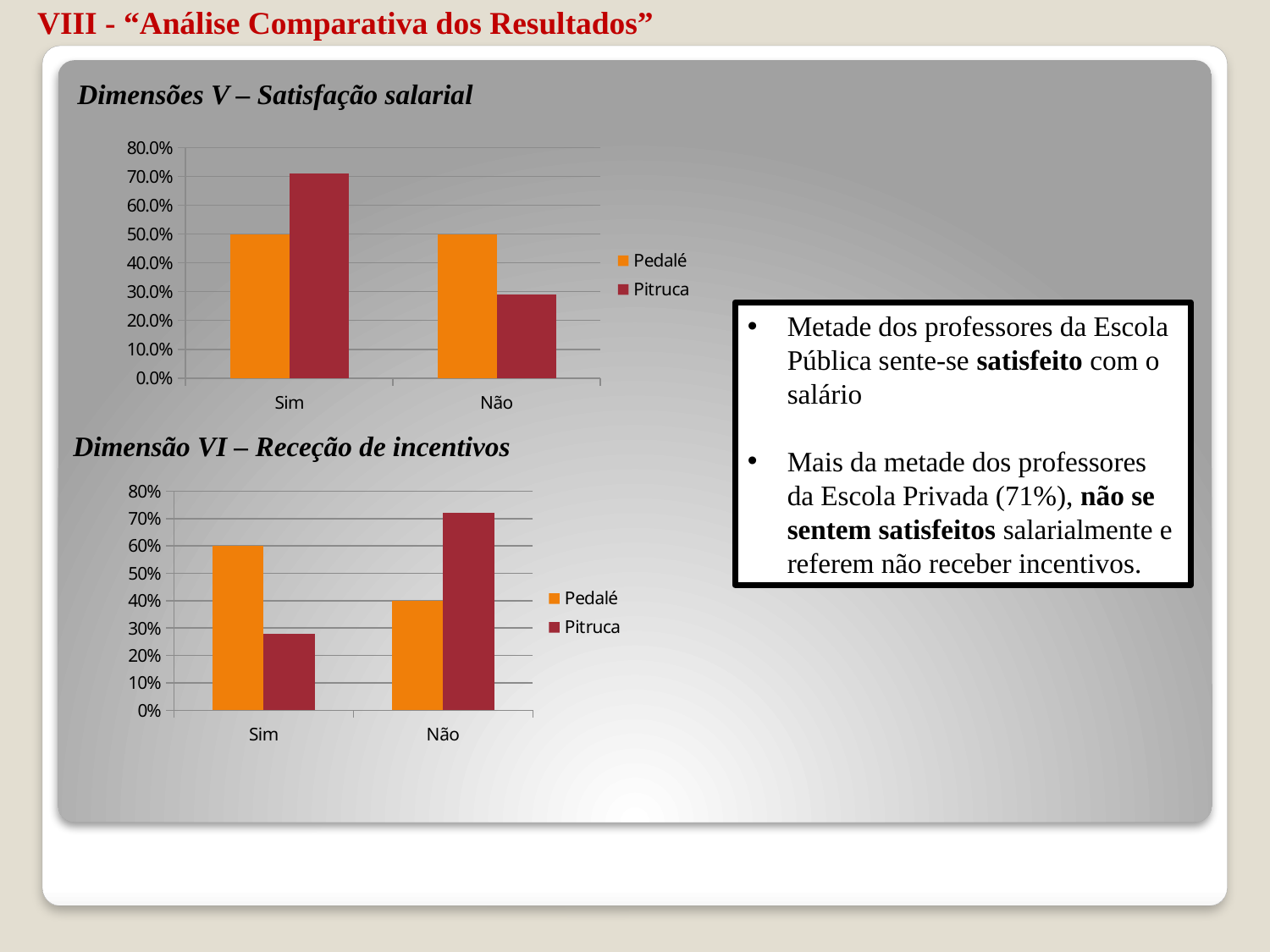
In the bottom chart (Dimensão VI – Receção de incentivos), what is the value for Pedalé in the Não category? 40% In the top chart (Dimensões V – Satisfação salarial), is the value for Pitruca in the Sim category greater or less than 60.0%? greater In the bottom chart (Dimensão VI – Receção de incentivos), which bar is the shortest? Pitruca, Sim In the bottom chart (Dimensão VI – Receção de incentivos), how many categories are on the x axis? 2 In the top chart (Dimensões V – Satisfação salarial), what kind of chart is shown? Bar chart In the top chart (Dimensões V – Satisfação salarial), which bar is the tallest? Pitruca, Sim In the top chart (Dimensões V – Satisfação salarial), which series has the higher value in the Não category? Pedalé In the bottom chart (Dimensão VI – Receção de incentivos), what is the value for Pedalé in the Sim category? 60% In the top chart (Dimensões V – Satisfação salarial), is the value for Pitruca in the Não category greater or less than 40.0%? less In the top chart (Dimensões V – Satisfação salarial), what is the value for Pedalé in the Sim category? 50.0% In the top chart (Dimensões V – Satisfação salarial), how many series does the legend list? 2 In the bottom chart (Dimensão VI – Receção de incentivos), is the value for Pitruca in the Não category greater or less than 60%? greater